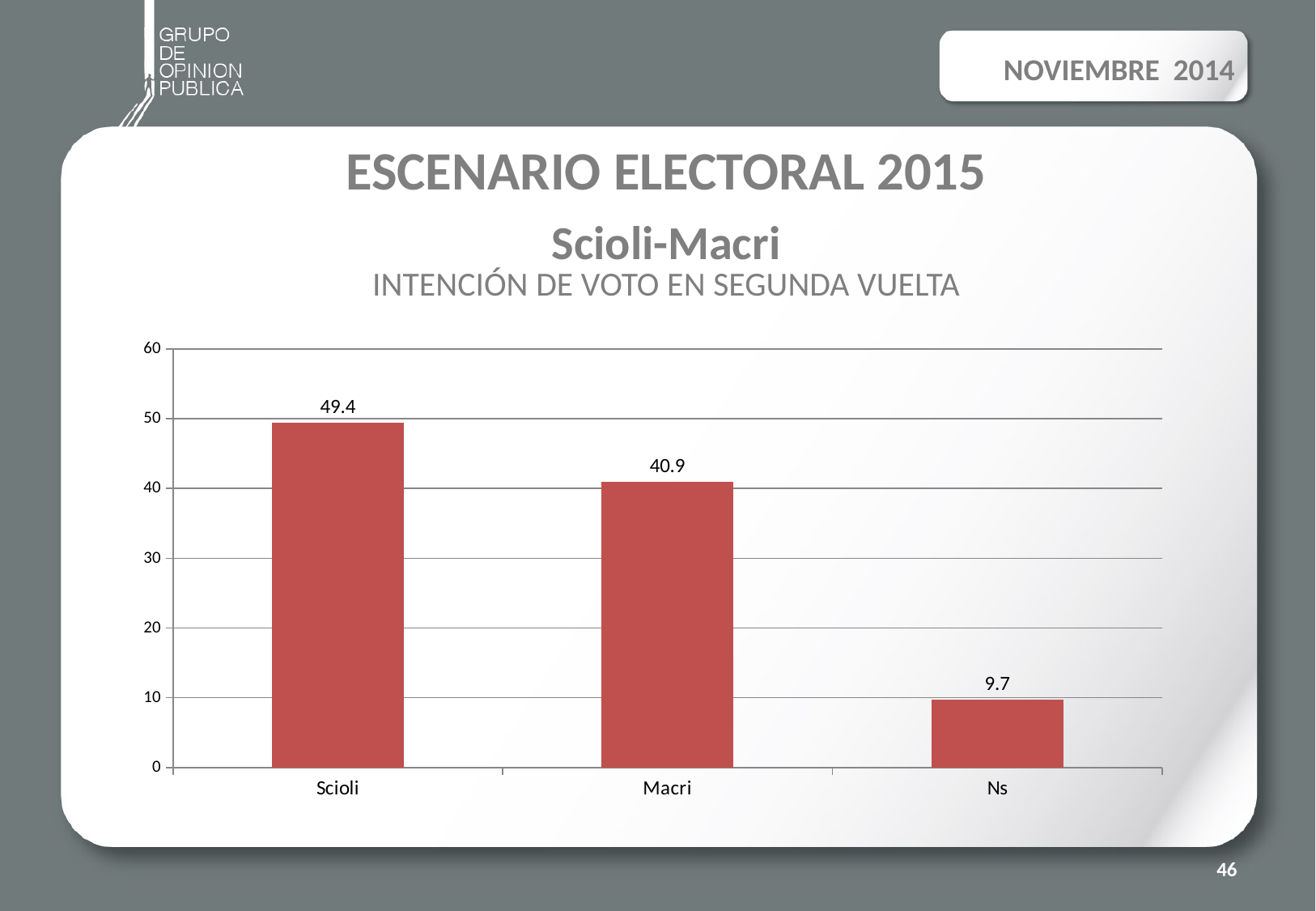
How many categories are shown on the x axis? 3 What is the difference between the values for Scioli and Macri? 8.5 What is the difference between the values for Macri and Ns? 31.2 What is the value for Macri? 40.9 Which is larger, the value for Scioli or the value for Macri? Scioli Which category has the lowest value? Ns What kind of chart is shown on the slide? bar chart Which category has the highest value? Scioli Is the value for Ns greater or less than 10? less What is the value for Scioli? 49.4 What is the subtitle shown below 'Scioli-Macri' above the chart? INTENCIÓN DE VOTO EN SEGUNDA VUELTA What is the value for Ns? 9.7